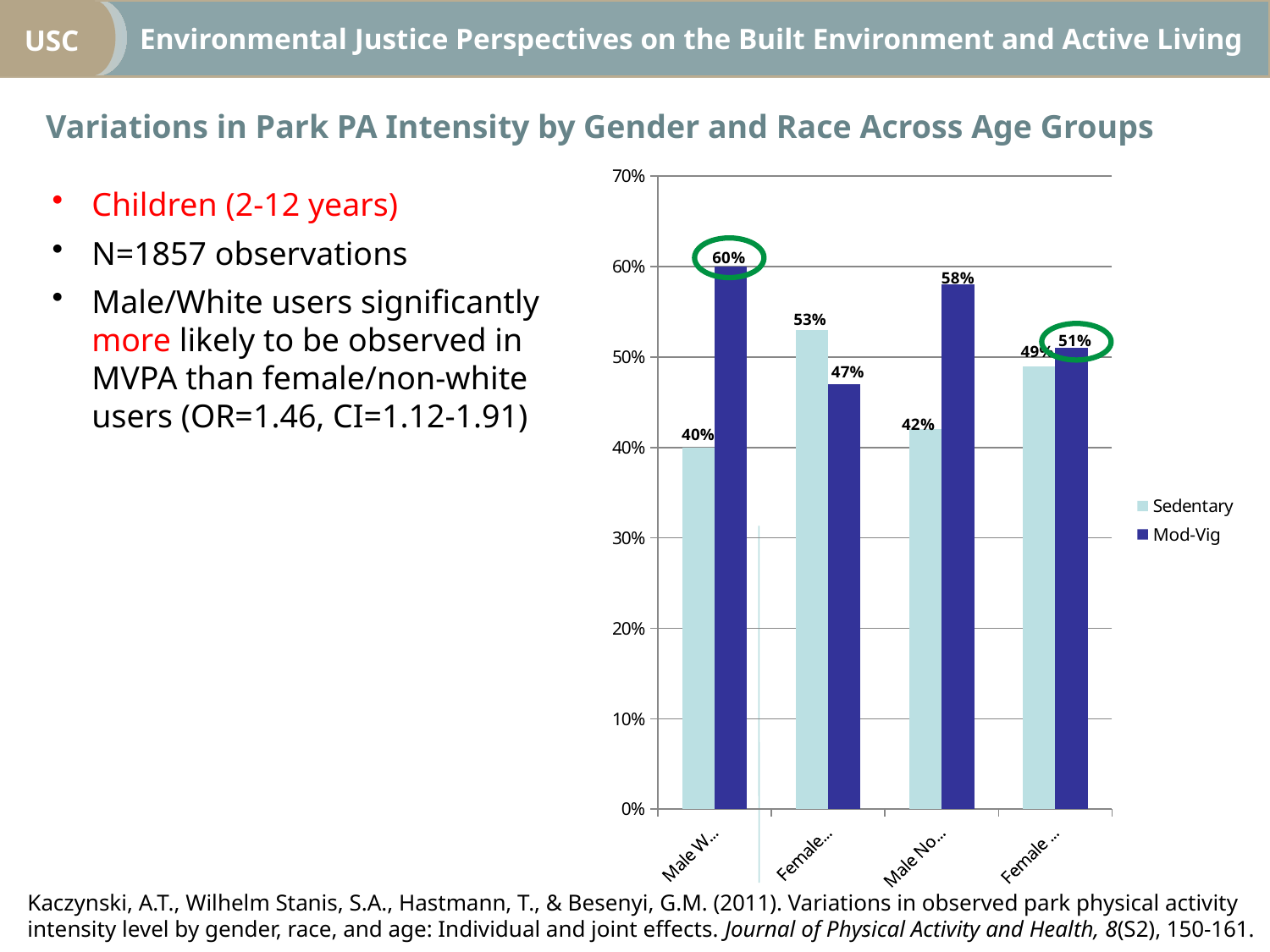
How many series does the chart legend list? 2 How many categories are plotted along the x axis of the chart? 4 In the second category, which is larger: the Sedentary value or the Mod-Vig value? Sedentary Which category has the lowest Sedentary value? The first category (Male W...) Is the Mod-Vig value for the third category (Male No...) greater or less than 50%? greater Which category has the highest Mod-Vig value? The first category (Male W...) In the first category (Male W...), what is the difference between the Mod-Vig and Sedentary values? 20 percentage points What is the difference between the Mod-Vig values of the first category (Male W...) and the third category (Male No...)? 2 percentage points What is the Sedentary value for the third category (Male No...)? 42% What type of chart is shown on the slide? Bar chart What is the Mod-Vig value for the first category (Male W...)? 60% What are the two entries listed in the chart legend? Sedentary and Mod-Vig